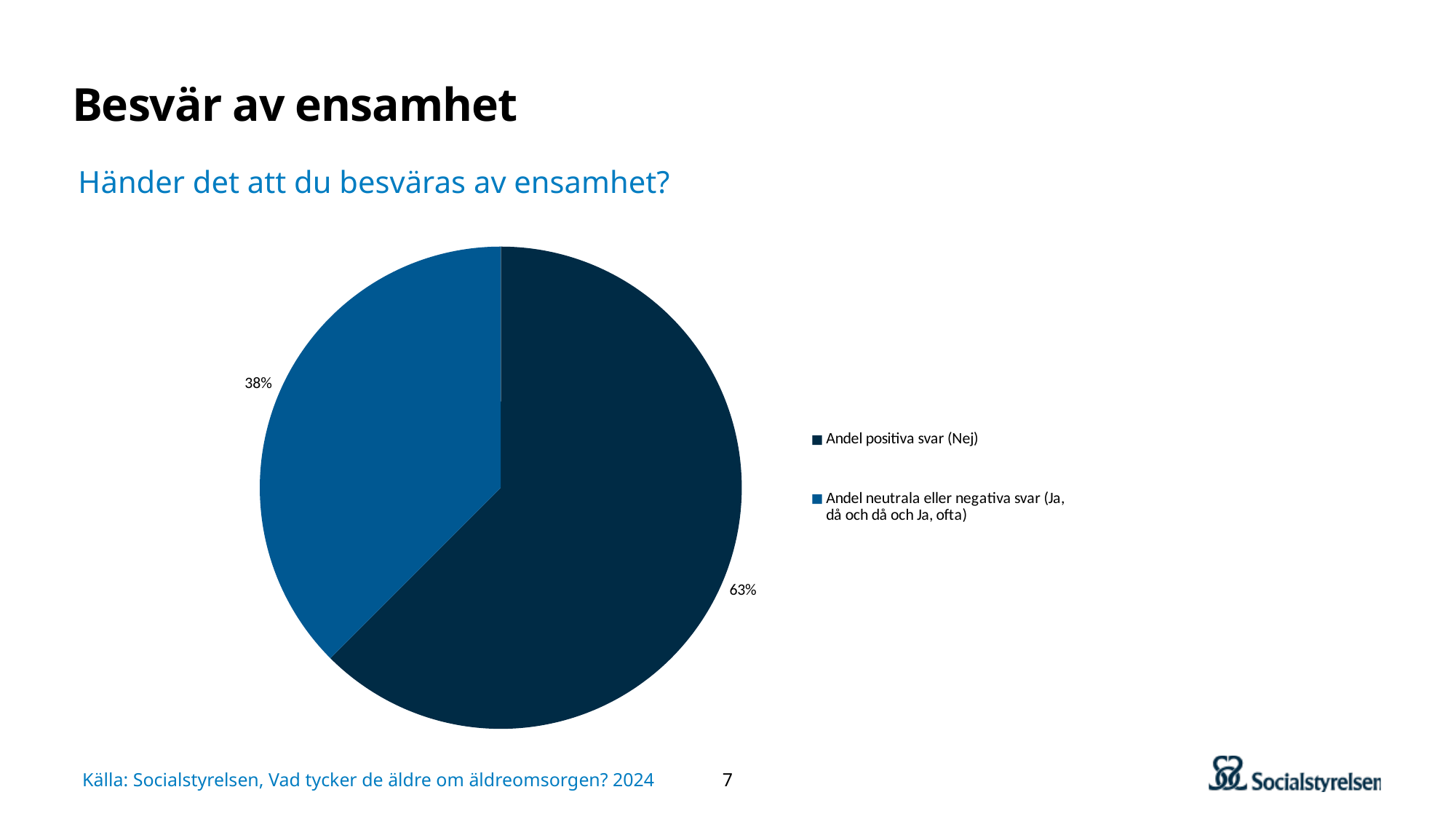
What share of the pie is 'Andel positiva svar (Nej)'? 63% Which slice of the pie is the smallest? Andel neutrala eller negativa svar (Ja, då och då och Ja, ofta) How many slices does the pie chart have? 2 Which colour represents 'Andel positiva svar (Nej)' in the pie chart? dark navy blue Which slice of the pie is the largest? Andel positiva svar (Nej) What kind of chart is shown on the slide? pie chart What question is shown as the chart's subtitle? Händer det att du besväras av ensamhet? What share of the pie is 'Andel neutrala eller negativa svar (Ja, då och då och Ja, ofta)'? 38% What is the difference in percentage points between the 'Andel positiva svar (Nej)' slice and the 'Andel neutrala eller negativa svar' slice? 25 percentage points Which is larger: the share of positive answers (Nej) or the share of neutral or negative answers? Andel positiva svar (Nej) How many entries does the legend list? 2